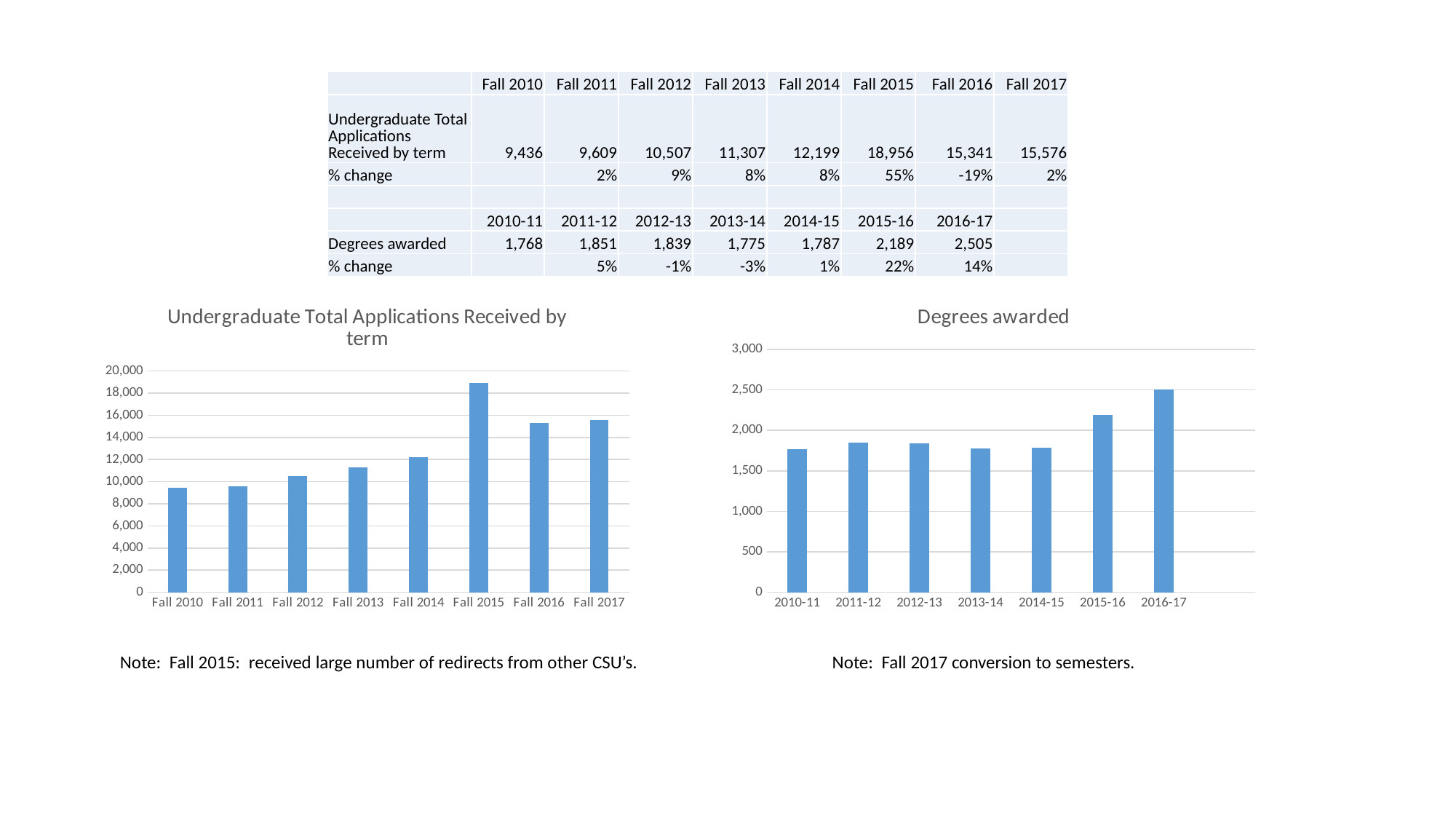
In the 'Undergraduate Total Applications Received by term' chart, what is the value for Fall 2015? 18,956 In the 'Degrees awarded' chart, what is the value for 2016-17? 2,505 In the 'Degrees awarded' chart, which year has the highest value? 2016-17 In the 'Degrees awarded' chart, which is larger, 2015-16 or 2016-17? 2016-17 In the 'Undergraduate Total Applications Received by term' chart, which term has the highest value? Fall 2015 In the 'Undergraduate Total Applications Received by term' chart, what is the difference between Fall 2015 and Fall 2016? 3,615 In the 'Undergraduate Total Applications Received by term' chart, how many terms are plotted? 8 In the 'Undergraduate Total Applications Received by term' chart, which term has the lowest value? Fall 2010 What type of chart is the 'Degrees awarded' chart? bar chart In the 'Degrees awarded' chart, is the value for 2015-16 greater or less than 2,000? greater In the 'Degrees awarded' chart, how many years are plotted? 7 In the 'Undergraduate Total Applications Received by term' chart, is the value for Fall 2014 greater or less than 14,000? less